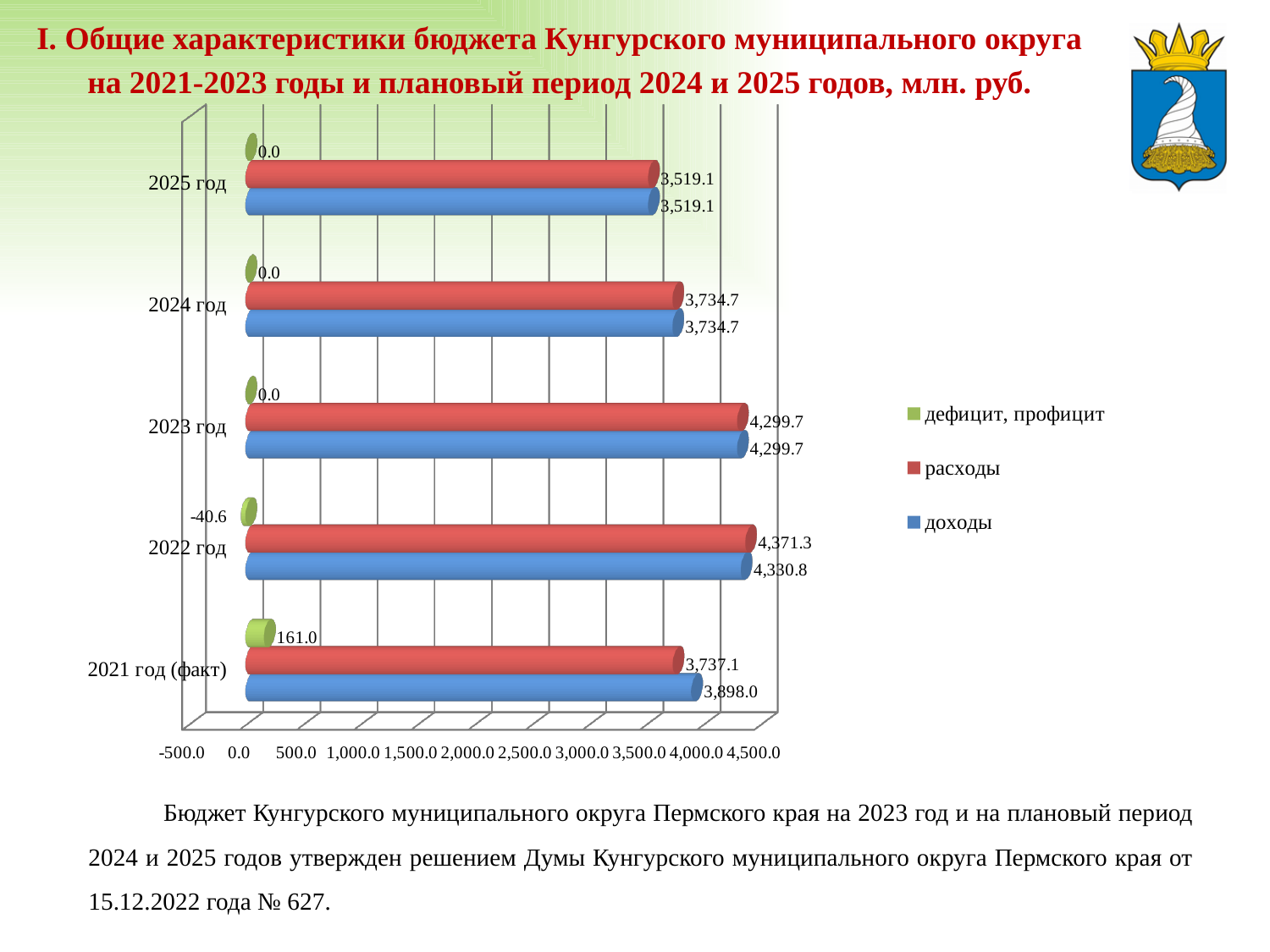
How many years (categories) are shown on the chart? 5 What is the value of дефицит, профицит for 2022 год? -40.6 What type of chart is shown on the slide? bar chart Which colour represents доходы in the chart? blue What is the value of доходы for 2025 год? 3,519.1 How many series does the legend list? 3 Which is larger for 2022 год: доходы or расходы? расходы What is the difference between доходы and расходы for 2021 год (факт)? 160.9 Which year has the lowest value of доходы? 2025 год What is the value of доходы for 2021 год (факт)? 3,898.0 What is the value of расходы for 2022 год? 4,371.3 Which year has the highest value of расходы? 2022 год